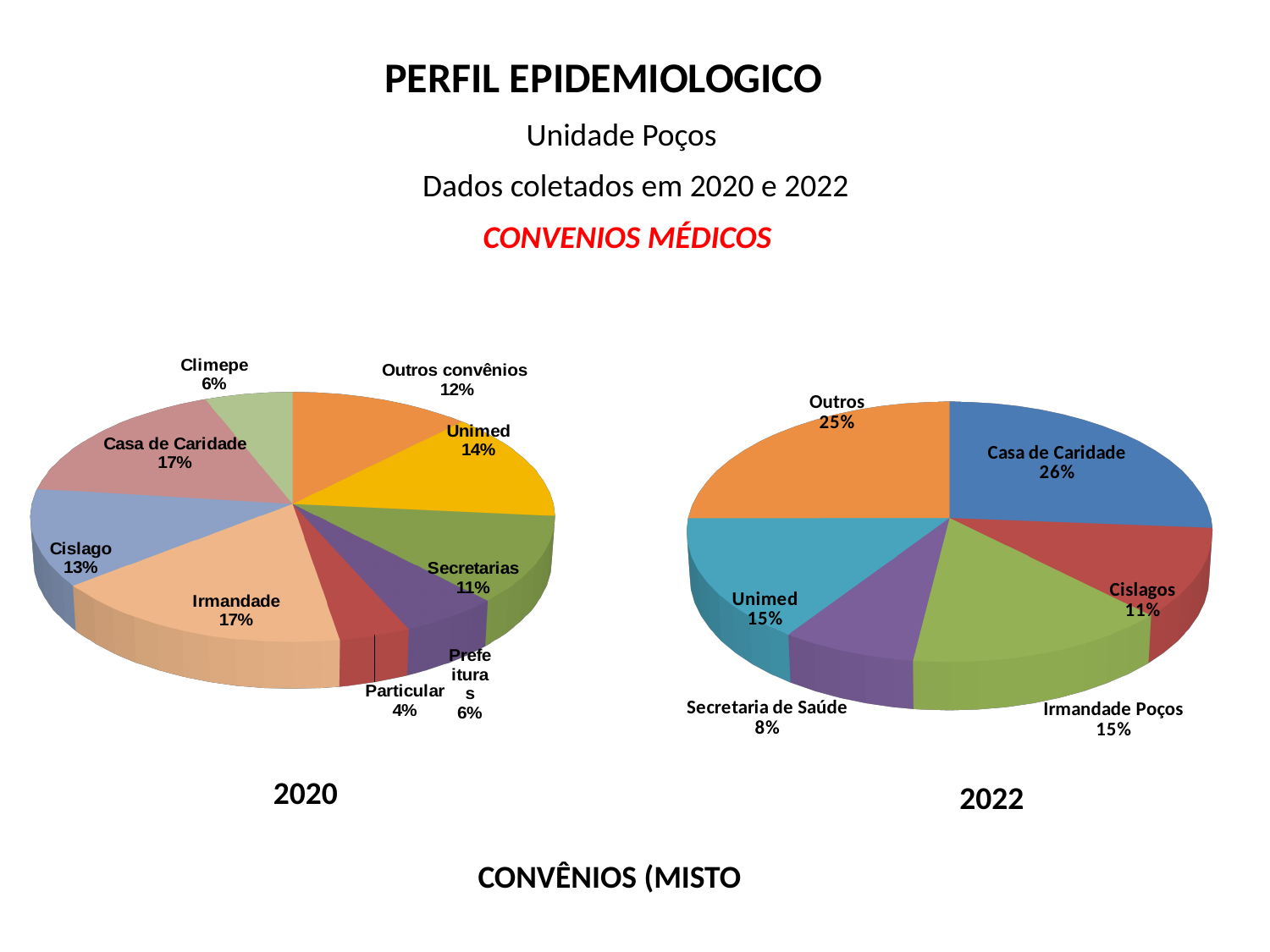
What kind of chart is the 2020 chart on the left? Pie chart In the 2022 pie chart, which is larger: Unimed or Cislagos? Unimed In the 2020 pie chart, what is the difference between the shares of Casa de Caridade and Climepe? 11% In the 2020 pie chart, which category has the smallest share? Particular In the 2022 pie chart, which category has the largest share? Casa de Caridade In the 2022 pie chart, which category has the smallest share? Secretaria de Saúde How many slices does the 2020 pie chart have? 9 In the 2022 pie chart, what share does Outros have? 25% In the 2020 pie chart, what share does Cislago have? 13% In the 2020 pie chart, what share does Unimed have? 14% How many slices does the 2022 pie chart have? 6 What is the red subtitle shown above the two pie charts? CONVENIOS MÉDICOS